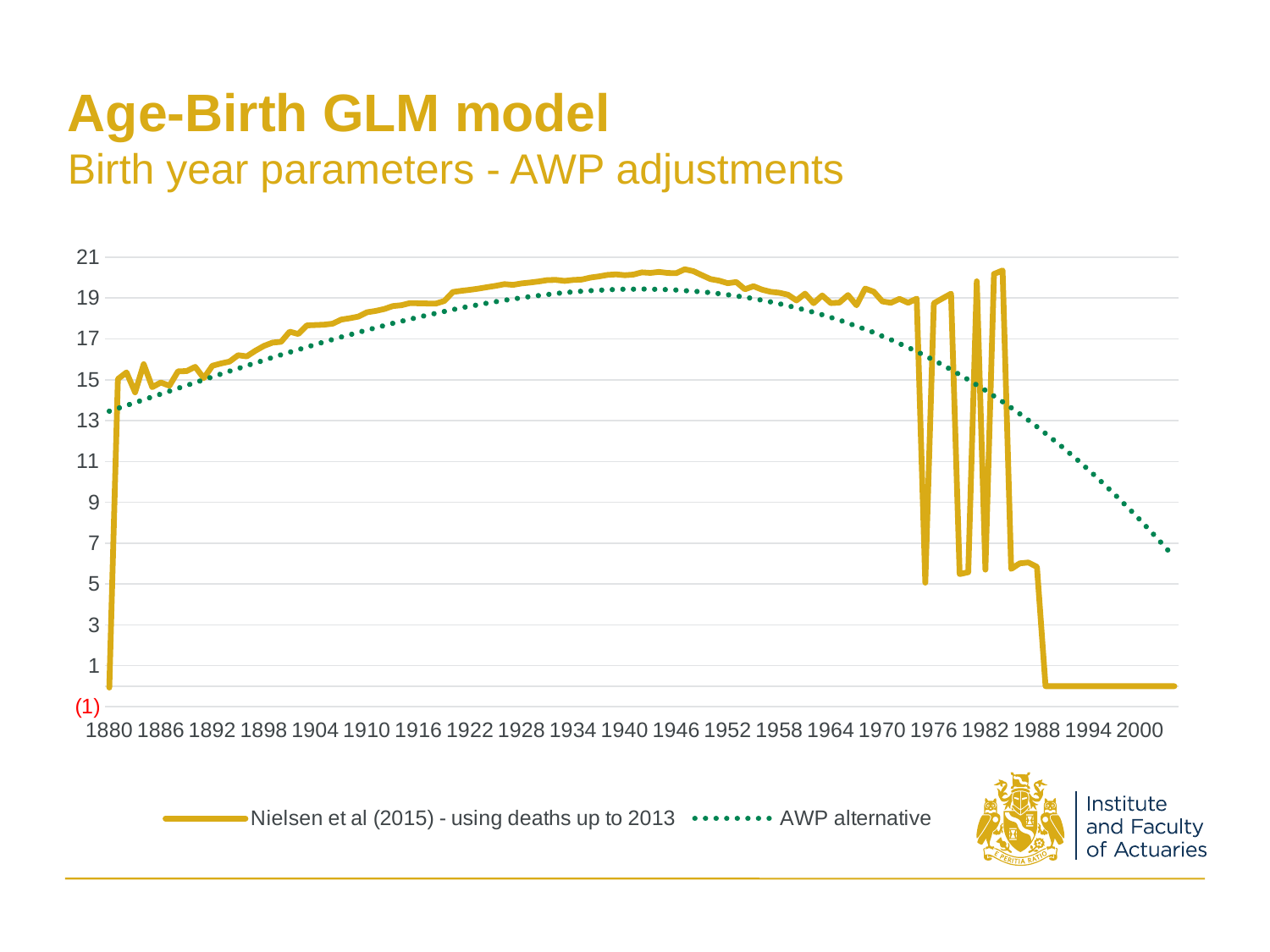
What is the highest value labelled on the y axis? 21 Does the Nielsen et al (2015) series generally rise or fall between 1886 and 1940? rise Which series is drawn as a dotted line? AWP alternative At 2000, which series has the higher value, Nielsen et al (2015) or AWP alternative? AWP alternative Is the value of the AWP alternative series at 2000 greater or less than 9? less Is the value of the Nielsen et al (2015) series at 1940 greater or less than 19? greater How many series does the legend list? 2 Is the value of the Nielsen et al (2015) series at 1994 greater or less than 1? less What are the two series named in the legend? Nielsen et al (2015) - using deaths up to 2013; AWP alternative What kind of chart is shown on the slide? line chart Does the AWP alternative series rise or fall between 1970 and 2000? fall